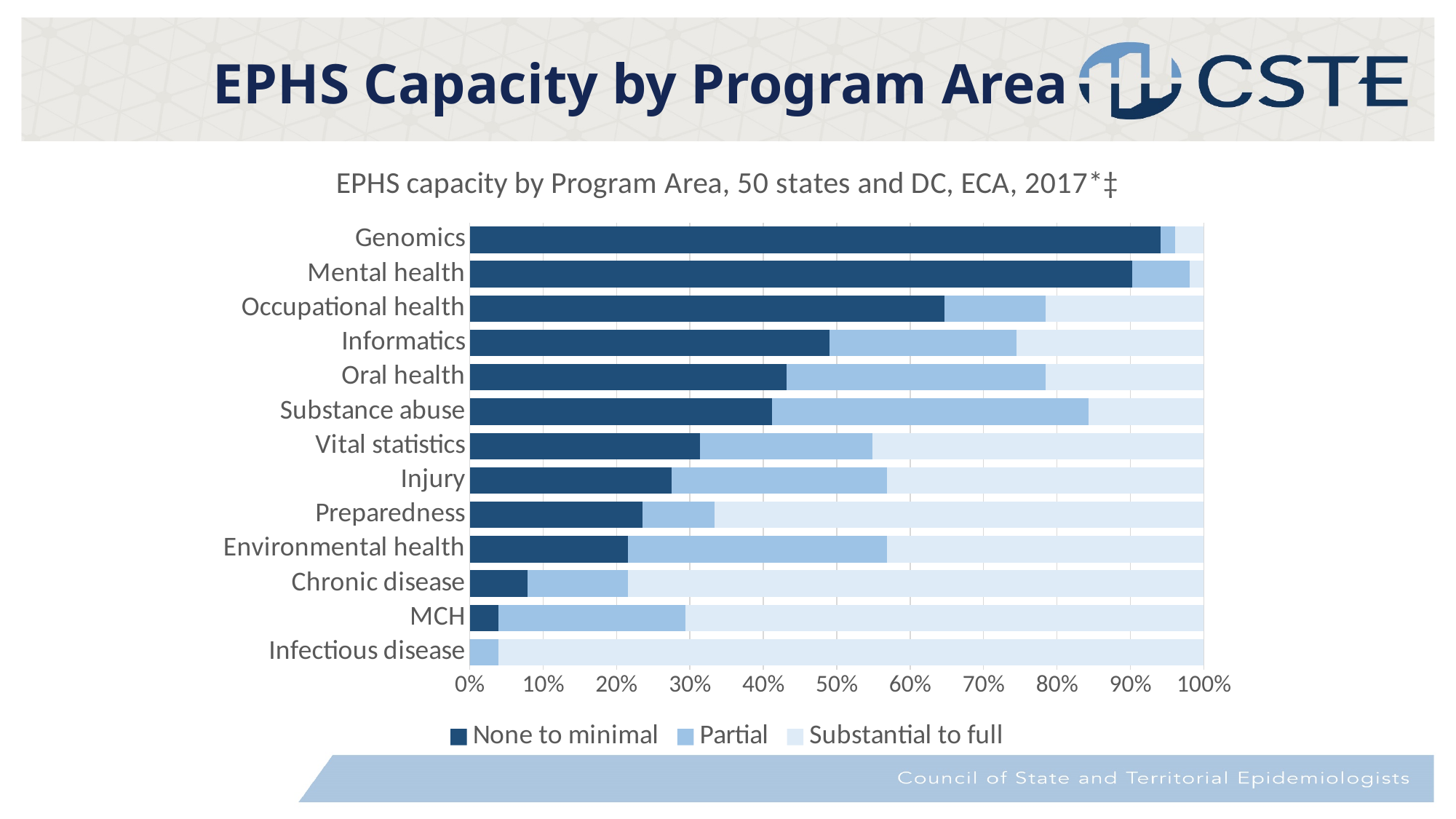
How many program areas are listed on the chart? 13 Is the 'None to minimal' share for Oral health greater or less than 50%? less Is the 'None to minimal' share for Occupational health greater or less than 60%? greater How many series does the legend list? 3 Which program area has the largest 'Substantial to full' share? Infectious disease Which program area has the smallest 'Substantial to full' share? Mental health Is the 'None to minimal' share for Genomics greater or less than 90%? greater Which has a larger 'None to minimal' share, Occupational health or Informatics? Occupational health Which program area has the largest 'None to minimal' share? Genomics What kind of chart is shown on the slide? Stacked bar chart Which program area has the largest 'Partial' share? Substance abuse What is the title of the chart? EPHS capacity by Program Area, 50 states and DC, ECA, 2017*‡